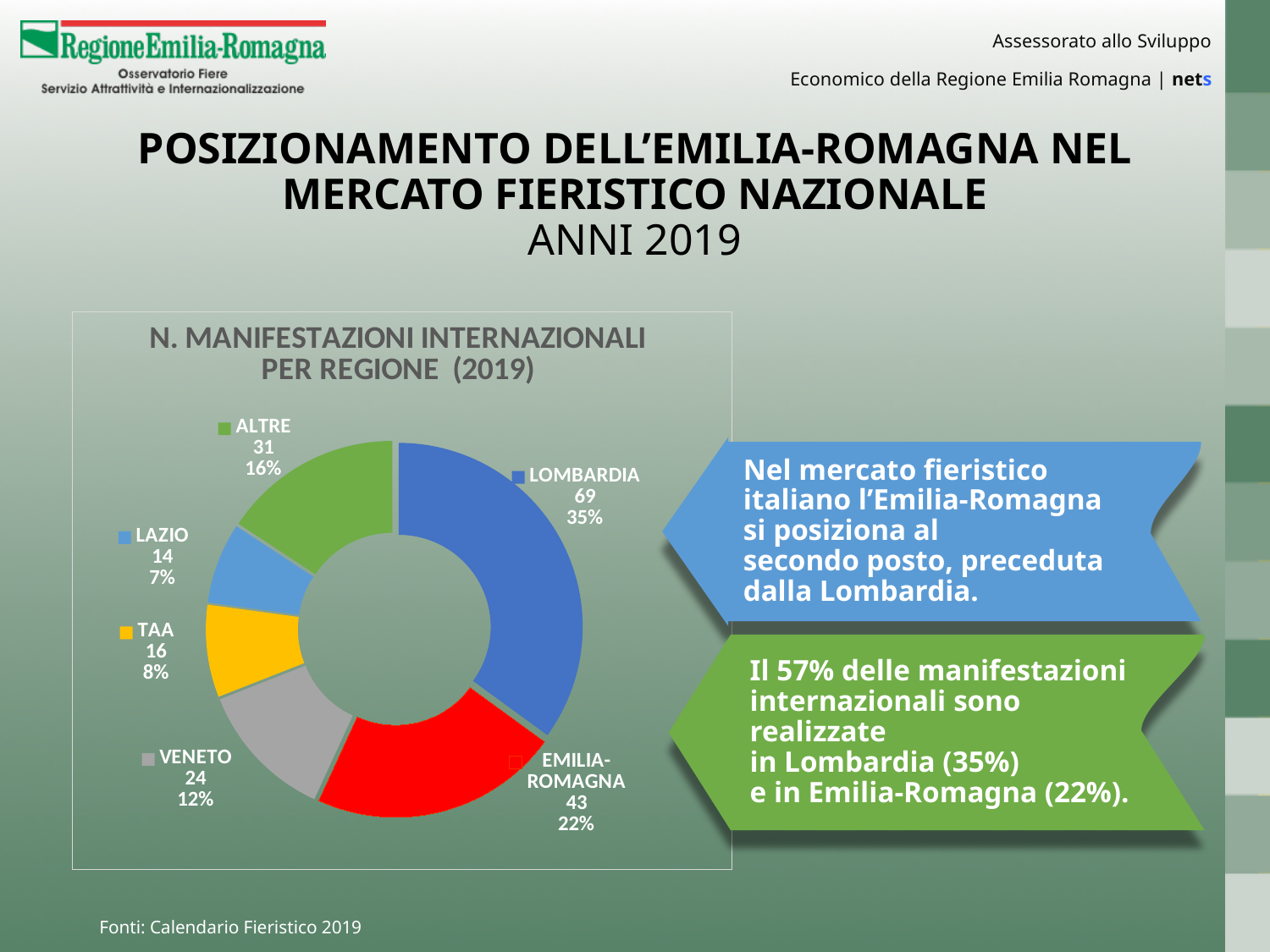
What is the difference between the number of events for LOMBARDIA and EMILIA-ROMAGNA? 26 Which region has the lowest number of international events? LAZIO What colour is the slice for EMILIA-ROMAGNA? Red What share of the chart does VENETO represent? 12% How many international events are shown for LOMBARDIA? 69 Which region has the highest number of international events? LOMBARDIA What kind of chart is shown on the slide? Doughnut (pie) chart What is the title of the chart? N. MANIFESTAZIONI INTERNAZIONALI PER REGIONE (2019) How many regions (categories) are shown in the chart? 6 How many international events are shown for EMILIA-ROMAGNA? 43 What share of the chart does LAZIO represent? 7% Which has more international events, TAA or VENETO? VENETO